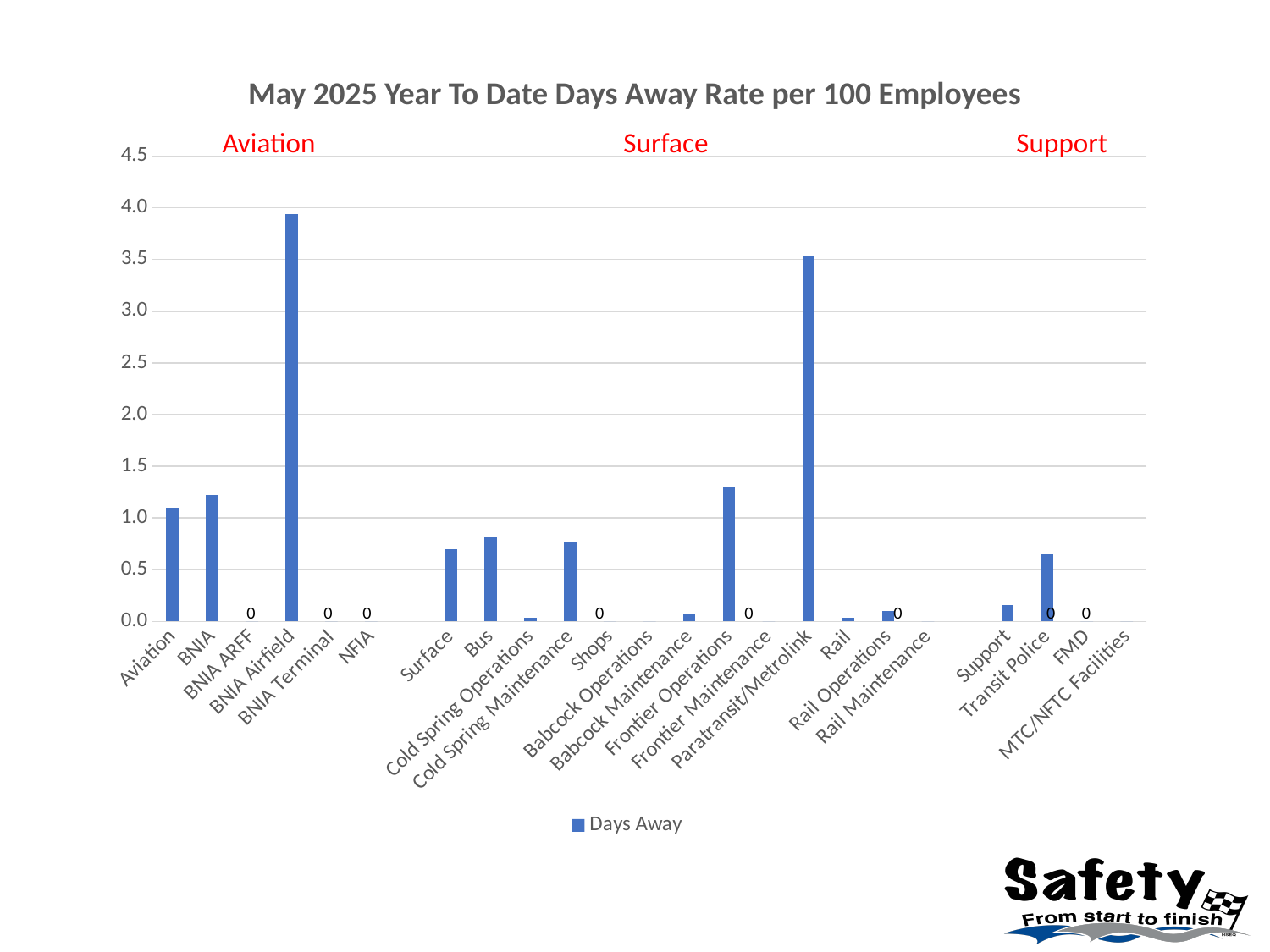
What is the days away rate for Frontier Maintenance? 0 How many series does the legend list? 1 Is the value for BNIA Airfield greater or less than 3.5? greater Which is larger, the value for Frontier Operations or the value for Bus? Frontier Operations What is the days away rate for BNIA ARFF? 0 Is the value for Paratransit/Metrolink greater or less than 3.0? greater How many categories are shown on the x axis? 23 Is the value for Bus greater or less than 1.0? less What is the days away rate for Shops? 0 What is the title of the chart? May 2025 Year To Date Days Away Rate per 100 Employees Which category has the highest days away rate? BNIA Airfield What kind of chart is shown on the slide? Bar chart